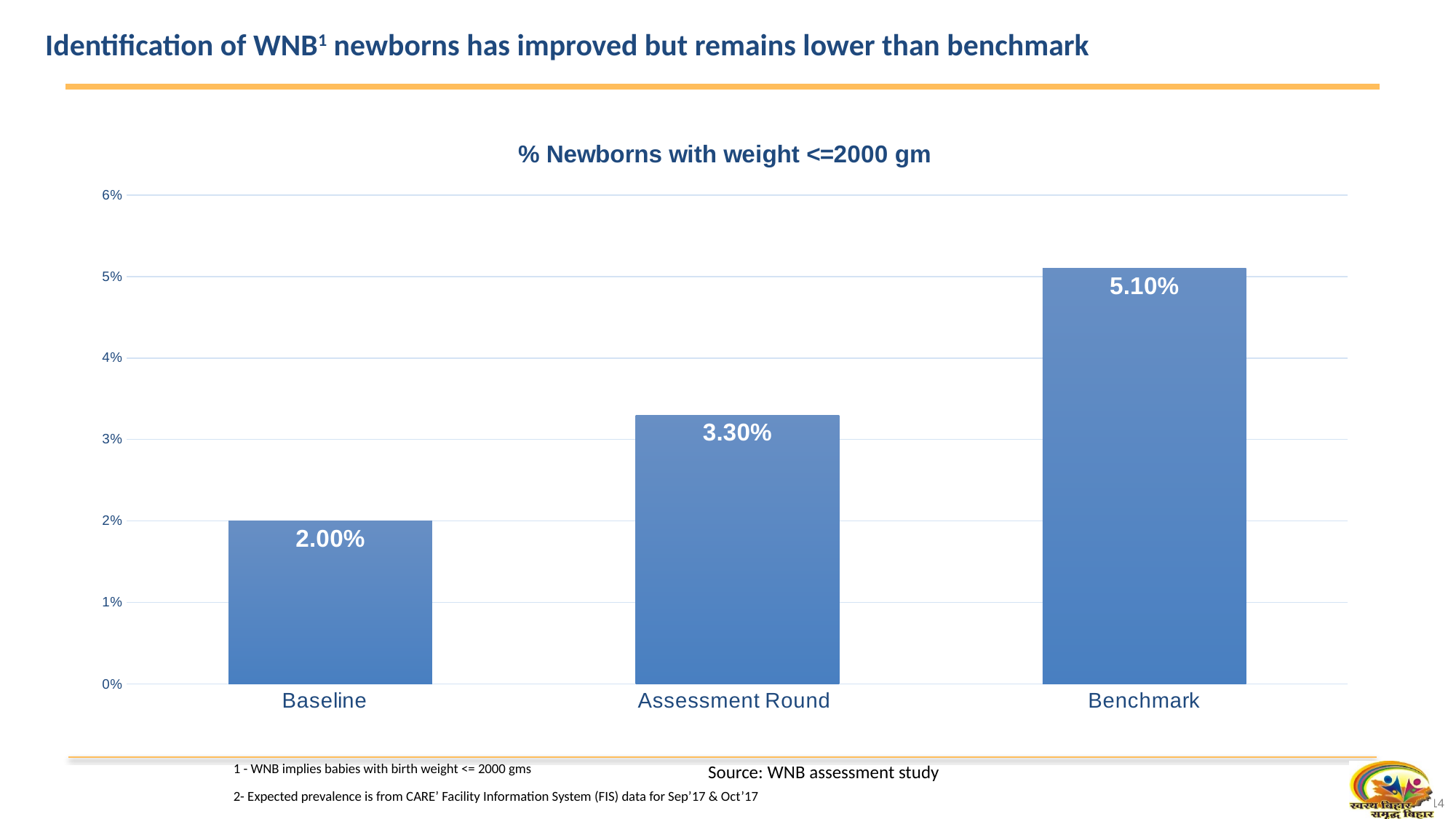
What is the difference between the Benchmark and Assessment Round values? 1.80% Which is larger, the value for Baseline or the value for Assessment Round? Assessment Round Which category has the lowest value? Baseline What is the value for Assessment Round? 3.30% What is the title of the chart? % Newborns with weight <=2000 gm Is the value for Benchmark greater or less than 4%? greater What is the value for Baseline? 2.00% What is the value for Benchmark? 5.10% Which category has the highest value? Benchmark What is the difference between the Assessment Round and Baseline values? 1.30% What kind of chart is shown on the slide? bar chart How many categories are shown on the x axis? 3